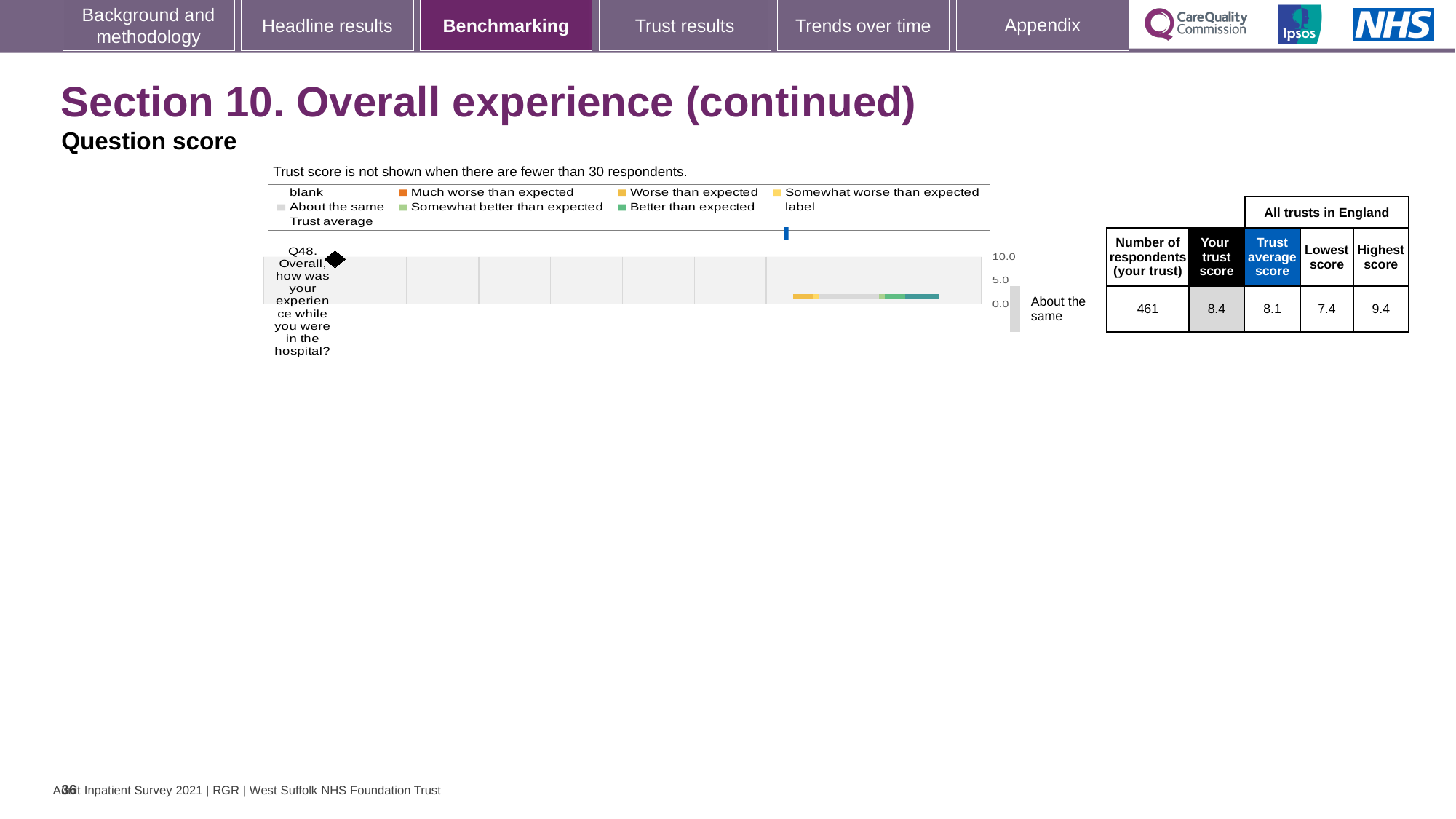
What is the highest score for Q48 among all trusts in England? 9.4 What is the highest value shown on the chart's axis? 10.0 What is the trust average score for Q48 across all trusts in England? 8.1 What is the difference between the highest score and the lowest score for Q48 among all trusts in England? 2.0 What kind of chart is shown on the slide? bar chart What is the trust score for Q48 shown in the table? 8.4 What is the lowest score for Q48 among all trusts in England? 7.4 Which question is plotted in the chart? Q48. Overall, how was your experience while you were in the hospital? Is the trust score for Q48 higher or lower than the trust average score? higher Which benchmarking category is the trust's Q48 score placed in? About the same How many respondents answered Q48 for this trust? 461 How many questions (categories) are plotted in the chart? 1